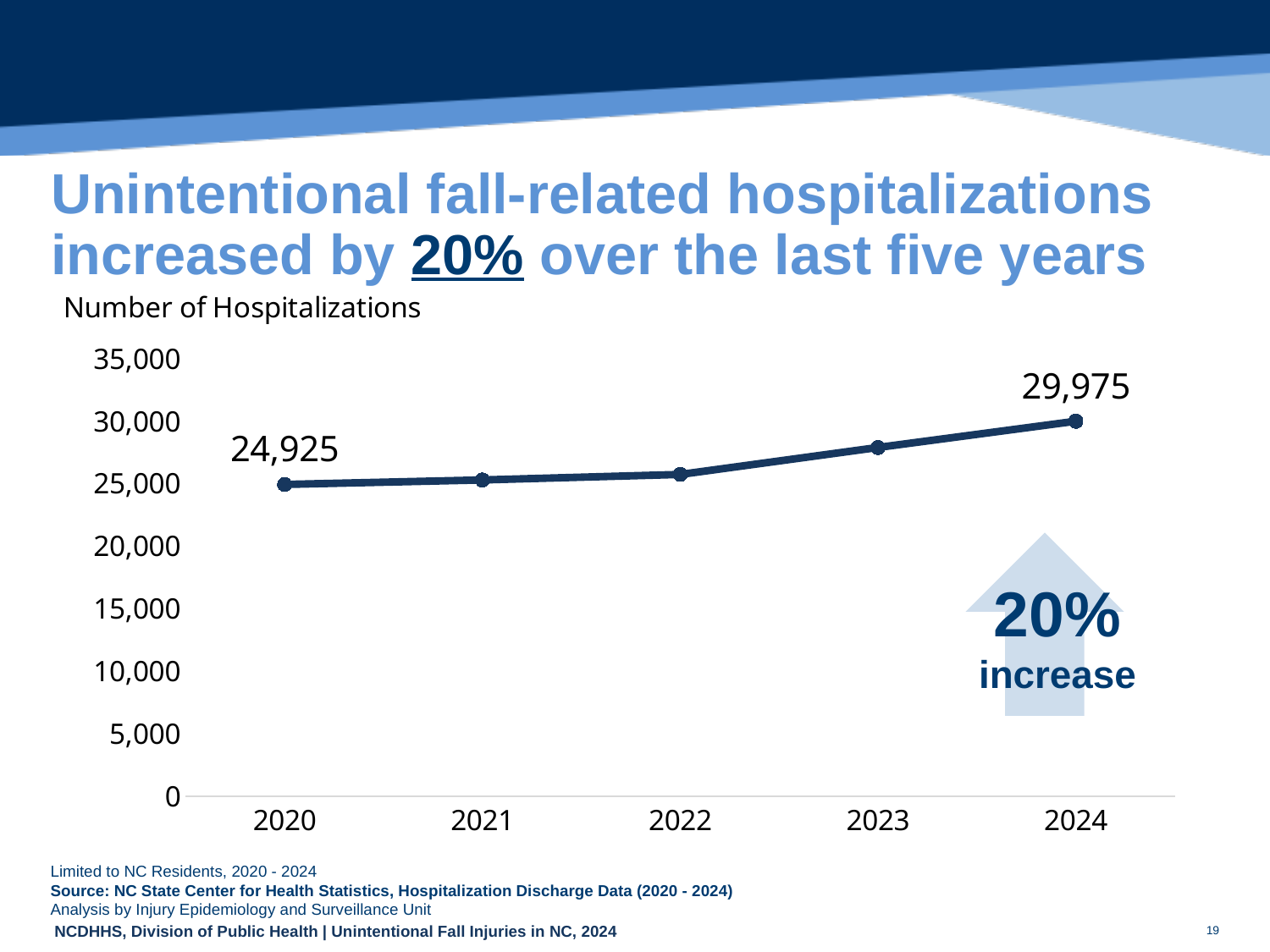
Which year has the highest number of hospitalizations? 2024 How many years are plotted on the chart? 5 Is the value for 2022 greater or less than 30,000? less Which year has the lowest number of hospitalizations? 2020 What kind of chart is shown on the slide? line chart What is the difference between the number of hospitalizations in 2024 and in 2020? 5,050 Which year has more hospitalizations, 2020 or 2024? 2024 Is the value for 2023 greater or less than 25,000? greater What is the number of hospitalizations in 2024? 29,975 What is the number of hospitalizations in 2020? 24,925 What percentage increase is highlighted in the arrow on the chart? 20% Do the number of hospitalizations rise or fall from 2020 to 2024? rise